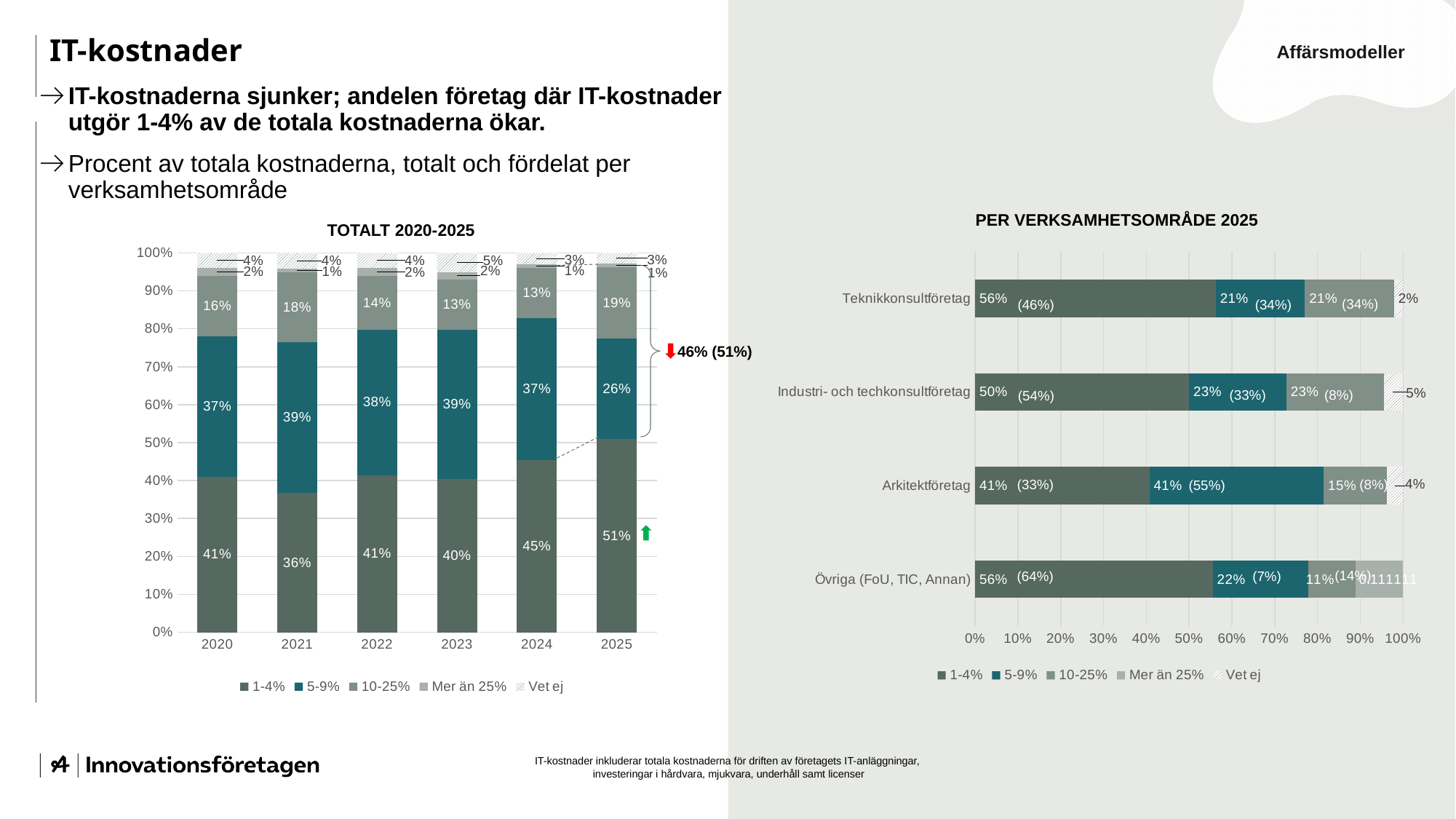
In the chart titled TOTALT 2020-2025, what is the value of the 1-4% series for 2025? 51% In the chart titled TOTALT 2020-2025, which year has the larger 5-9% value, 2024 or 2025? 2024 In the chart titled PER VERKSAMHETSOMRÅDE 2025, what is the 1-4% value for Industri- och techkonsultföretag? 50% In the chart titled PER VERKSAMHETSOMRÅDE 2025, how many categories are shown? 4 In the chart titled TOTALT 2020-2025, what is the difference between the 1-4% value for 2025 and the 1-4% value for 2020? 10 percentage points In the chart titled TOTALT 2020-2025, which year has the lowest value for the 1-4% series? 2021 In the chart titled TOTALT 2020-2025, which year has the highest value for the 1-4% series? 2025 In the chart titled PER VERKSAMHETSOMRÅDE 2025, what is the Vet ej value for Industri- och techkonsultföretag? 5% In the chart titled TOTALT 2020-2025, how many series does the legend list? 5 What kind of chart is the chart titled PER VERKSAMHETSOMRÅDE 2025? Stacked bar chart In the chart titled TOTALT 2020-2025, what is the value of the 5-9% series for 2021? 39% In the chart titled TOTALT 2020-2025, how many years are shown on the x axis? 6